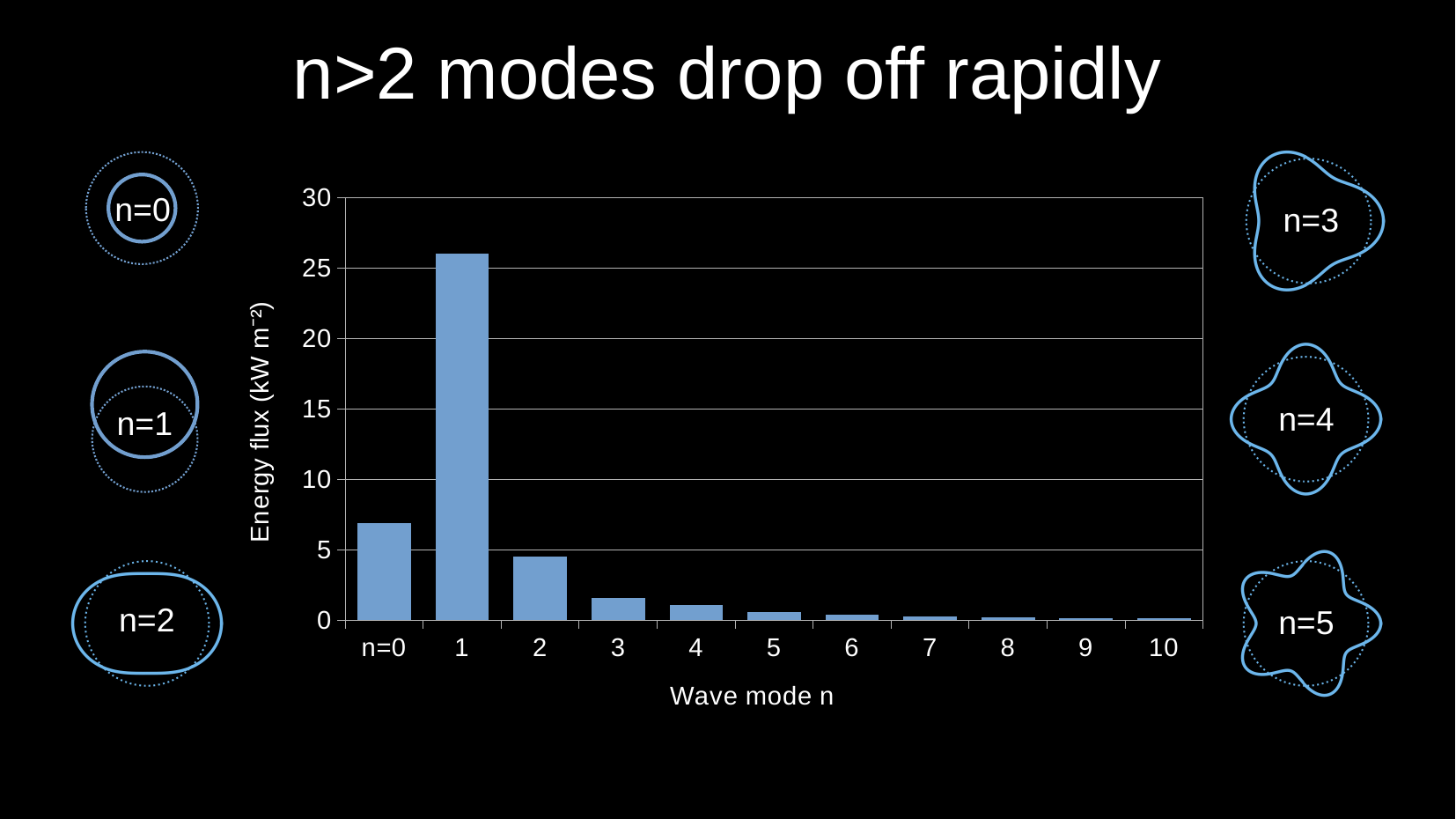
Is the energy flux for wave mode n=2 greater or less than 10 kW m⁻²? less What is the label of the y axis? Energy flux (kW m⁻²) Do the energy flux values rise or fall as the wave mode n increases from 1 to 10? fall What kind of chart is shown on the slide? bar chart Is the energy flux for wave mode n=0 greater or less than 10 kW m⁻²? less Is the energy flux for wave mode n=3 greater or less than 5 kW m⁻²? less Which wave mode has the highest energy flux? n=1 How many wave modes are plotted along the x axis? 11 Which has a larger energy flux, wave mode n=0 or wave mode n=2? n=0 What is the label of the x axis? Wave mode n